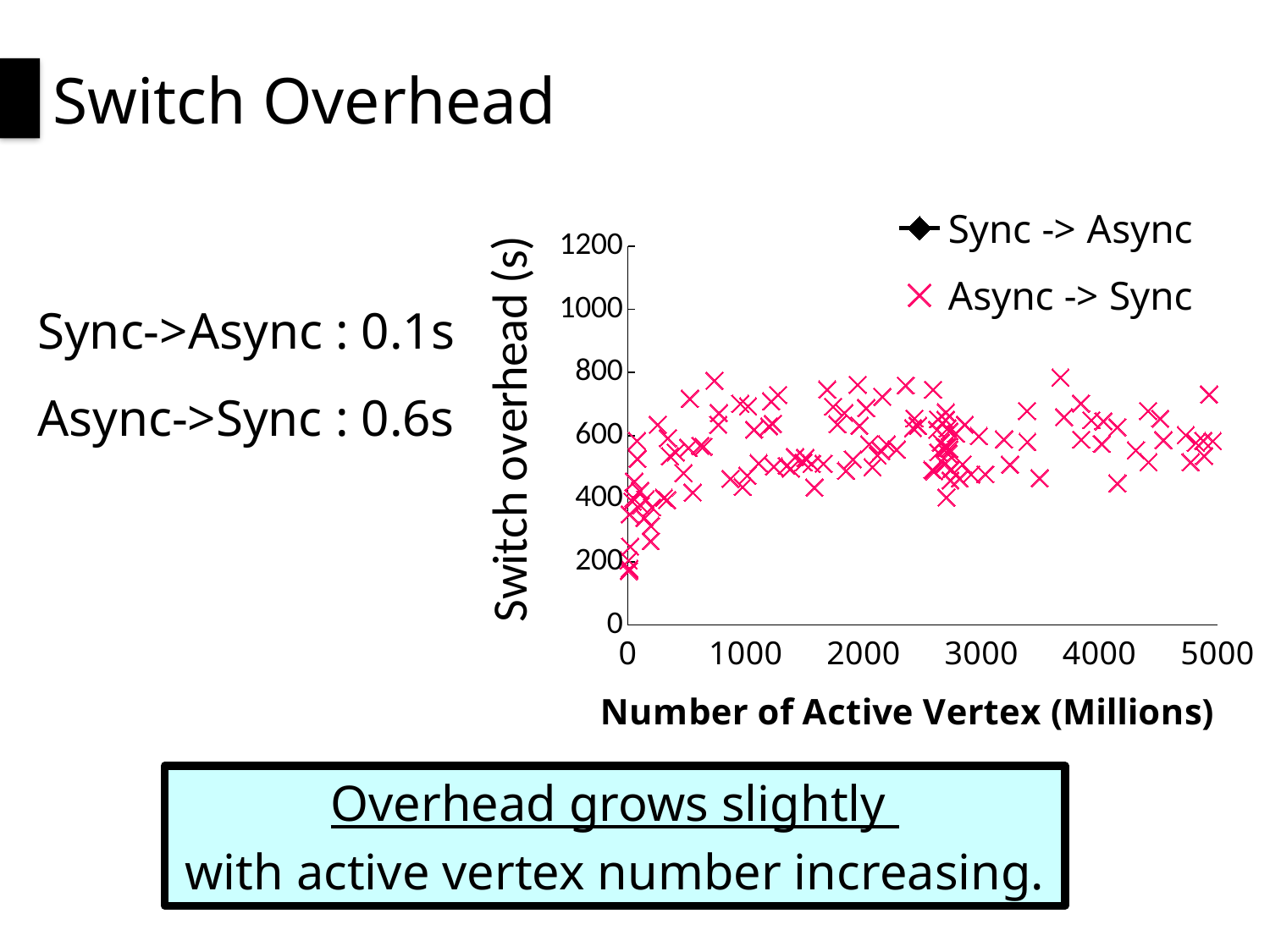
What are the two series named in the chart legend? Sync -> Async and Async -> Sync How many series does the chart legend list? 2 What is the label of the chart's y axis? Switch overhead (s) Is the lowest Async -> Sync switch overhead value greater or less than 400? less Are the Async -> Sync points near 0 million active vertices mostly greater or less than 800 seconds? less What kind of chart is shown on the slide? scatter chart Is the lowest Async -> Sync switch overhead value greater or less than 100? greater Do the Async -> Sync switch overhead values generally rise or fall as the number of active vertices increases? rise